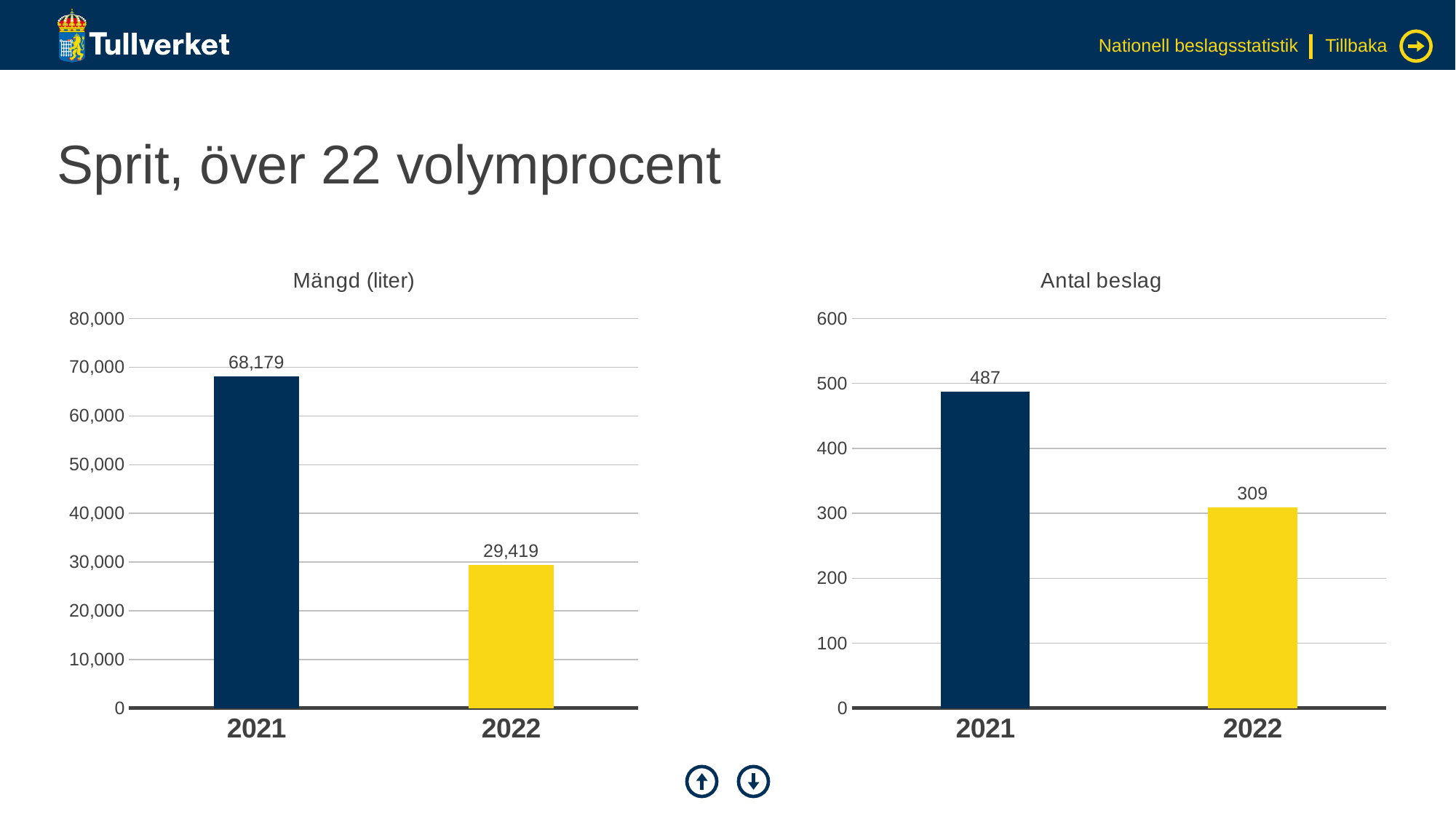
In the 'Antal beslag' chart, what is the difference between the 2021 and 2022 values? 178 In the 'Antal beslag' chart, what is the value for 2021? 487 How many categories are shown on the x axis of the 'Mängd (liter)' chart? 2 In the 'Mängd (liter)' chart, do the values rise or fall from 2021 to 2022? Fall In the 'Mängd (liter)' chart, which year has the highest value? 2021 In the 'Antal beslag' chart, which year has the lowest value? 2022 In the 'Antal beslag' chart, what is the value for 2022? 309 In the 'Mängd (liter)' chart, what is the value for 2022? 29,419 In the 'Antal beslag' chart, is the value for 2021 greater or less than 400? greater What kind of chart is the 'Antal beslag' chart? Bar chart In the 'Mängd (liter)' chart, what is the difference between the 2021 and 2022 values? 38,760 In the 'Mängd (liter)' chart, what is the value for 2021? 68,179